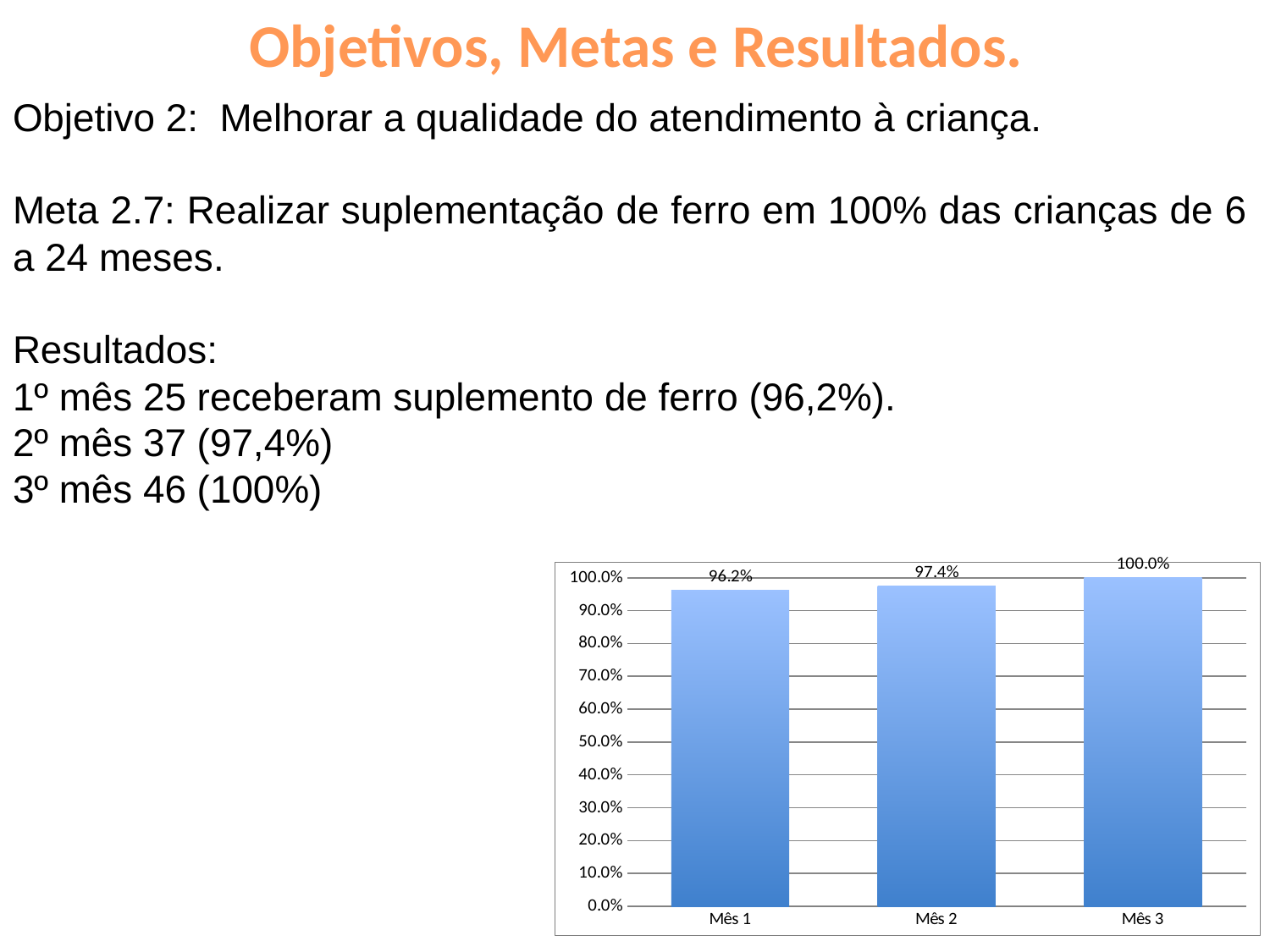
Do the values rise or fall from Mês 1 to Mês 3? rise Is the value for Mês 1 greater or less than 90.0%? greater What is the difference between the values for Mês 3 and Mês 1? 3.8% What is the difference between the values for Mês 2 and Mês 1? 1.2% How many categories are shown on the x axis? 3 Which month has the highest value? Mês 3 Which month has the lowest value? Mês 1 Which is larger, the value for Mês 2 or the value for Mês 3? Mês 3 What is the value for Mês 3? 100.0% What is the value for Mês 1? 96.2% What is the value for Mês 2? 97.4% What kind of chart is shown on the slide? bar chart